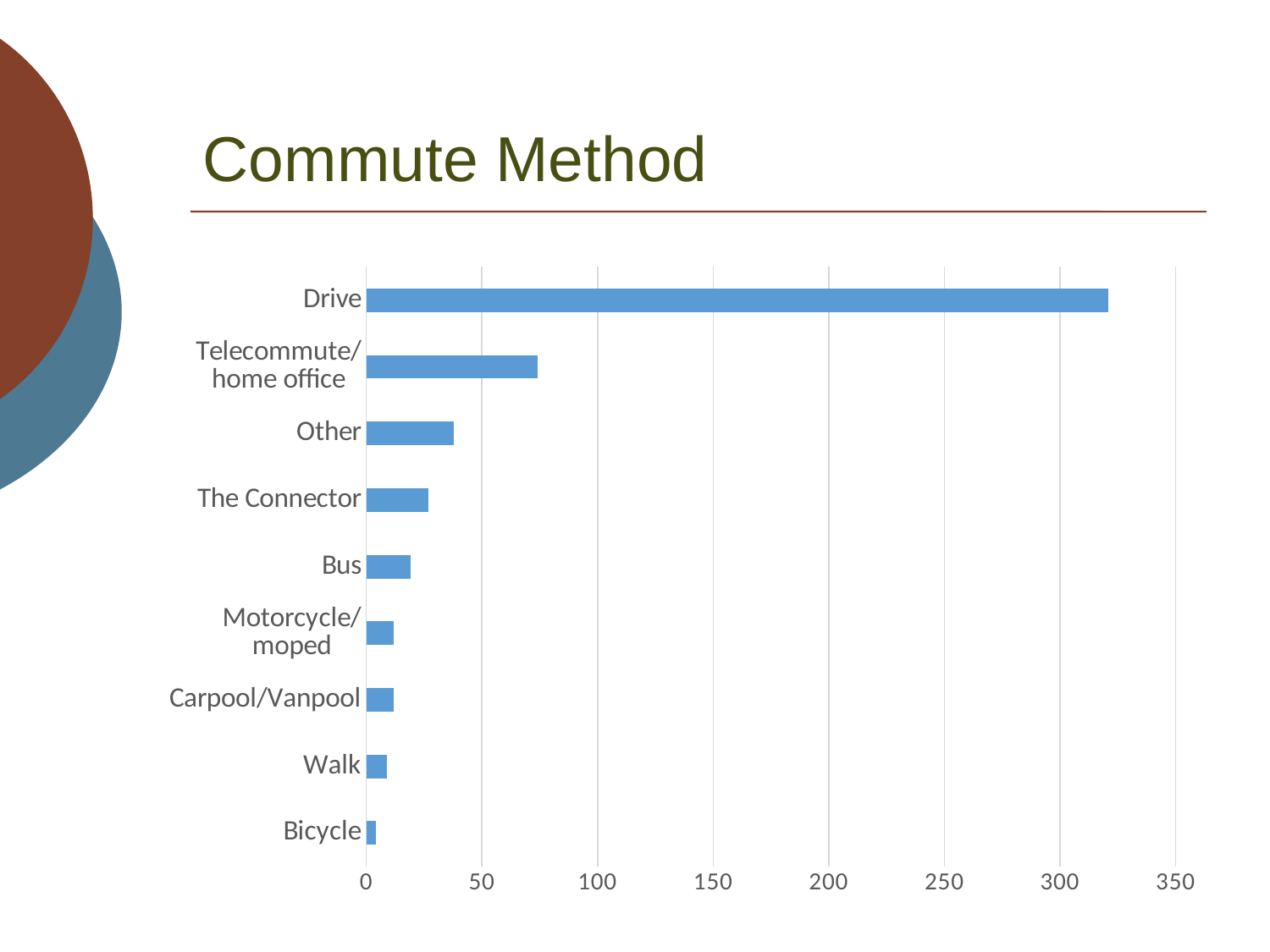
Which is larger, the value for Walk or the value for Bicycle? Walk Is the value for Telecommute/home office greater or less than 100? less How many commute method categories are plotted in the chart? 9 What is the title of the slide's chart? Commute Method What type of chart is shown on the slide? bar chart Which is larger, the value for Drive or the value for Telecommute/home office? Drive Is the value for Telecommute/home office greater or less than 50? greater Which commute method has the lowest value? Bicycle Which is larger, the value for Other or the value for Bus? Other Is the value for Other greater or less than 50? less Which commute method has the highest value? Drive